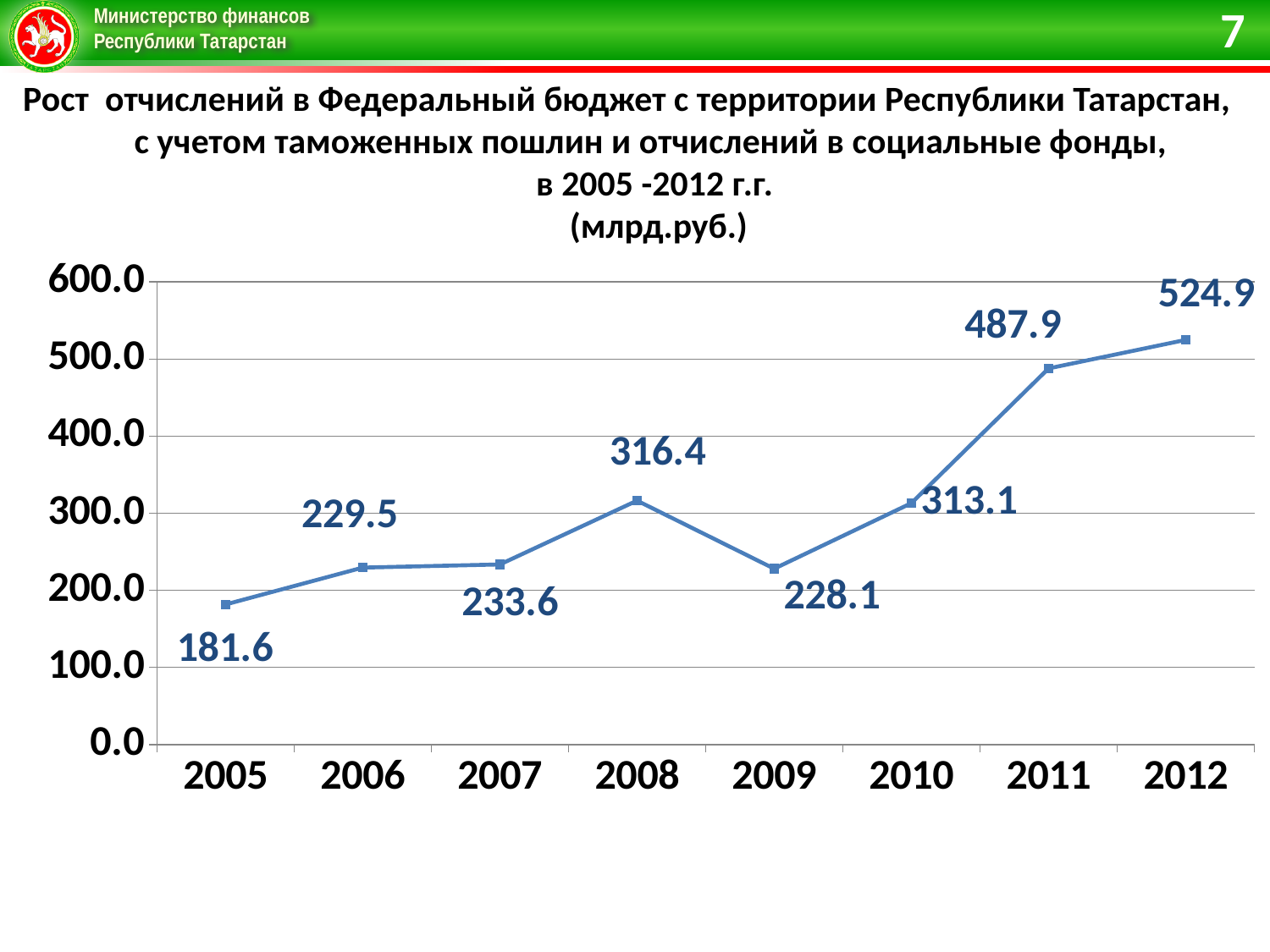
What is the difference between the values for 2012 and 2011? 37.0 What is the value for 2009? 228.1 Do the values rise or fall from 2009 to 2012? rise What is the difference between the values for 2008 and 2009? 88.3 Which year has the highest value? 2012 How many years are plotted on the chart? 8 What is the value for 2011? 487.9 What kind of chart is shown on the slide? line chart Which is larger, the value for 2008 or the value for 2010? 2008 What is the value for 2005? 181.6 Is the value for 2011 greater or less than 400.0? greater Which year has the lowest value? 2005